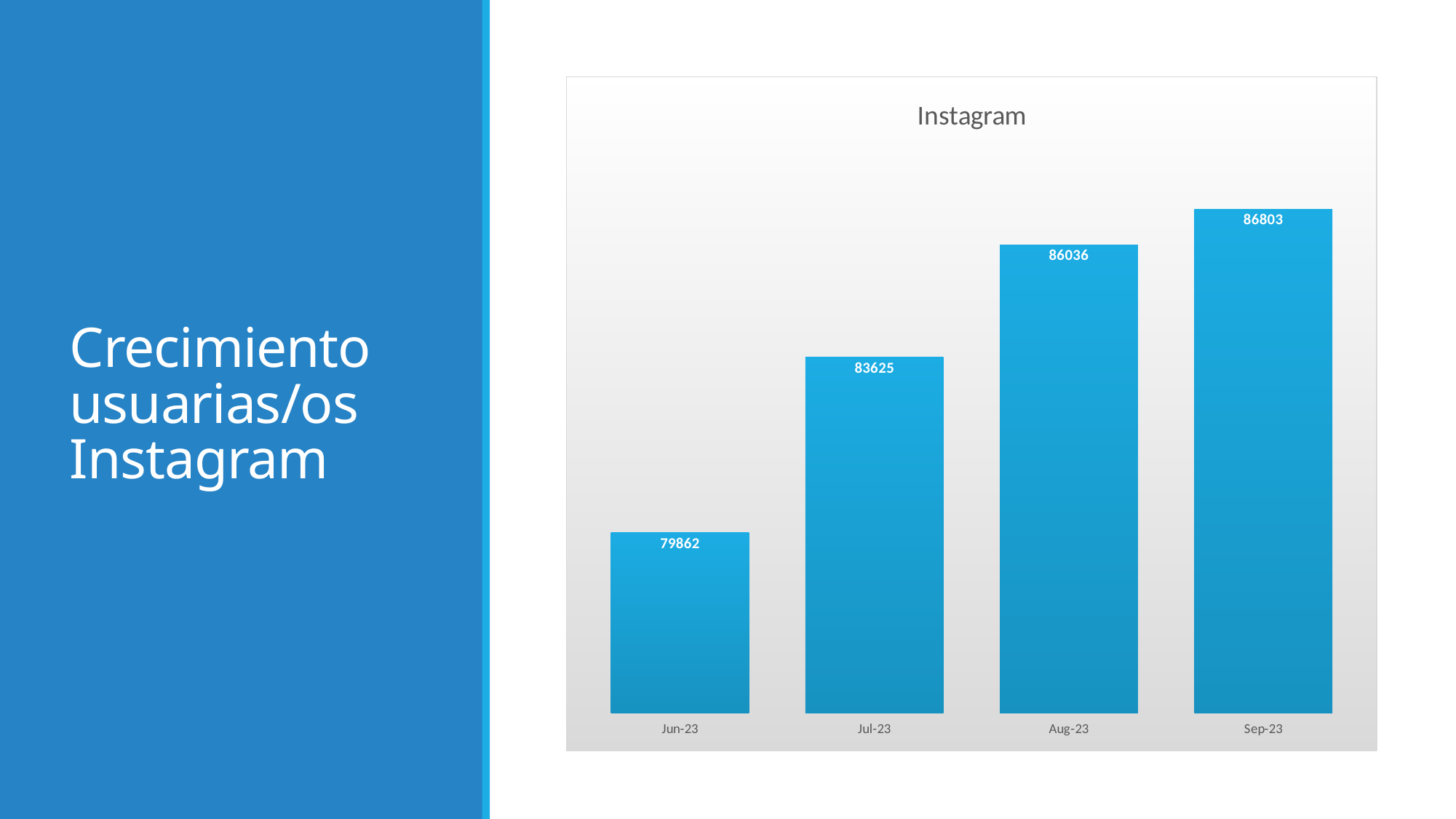
How many months are shown on the chart? 4 Which month has the highest value? Sep-23 What kind of chart is shown? Bar chart What is the value for Sep-23? 86803 What is the difference between the values for Jul-23 and Jun-23? 3763 What is the value for Jun-23? 79862 Which is larger, the value for Jul-23 or the value for Aug-23? Aug-23 Do the values rise or fall from Jun-23 to Sep-23? Rise What is the value for Aug-23? 86036 What is the difference between the values for Sep-23 and Jun-23? 6941 Which month has the lowest value? Jun-23 What is the value for Jul-23? 83625